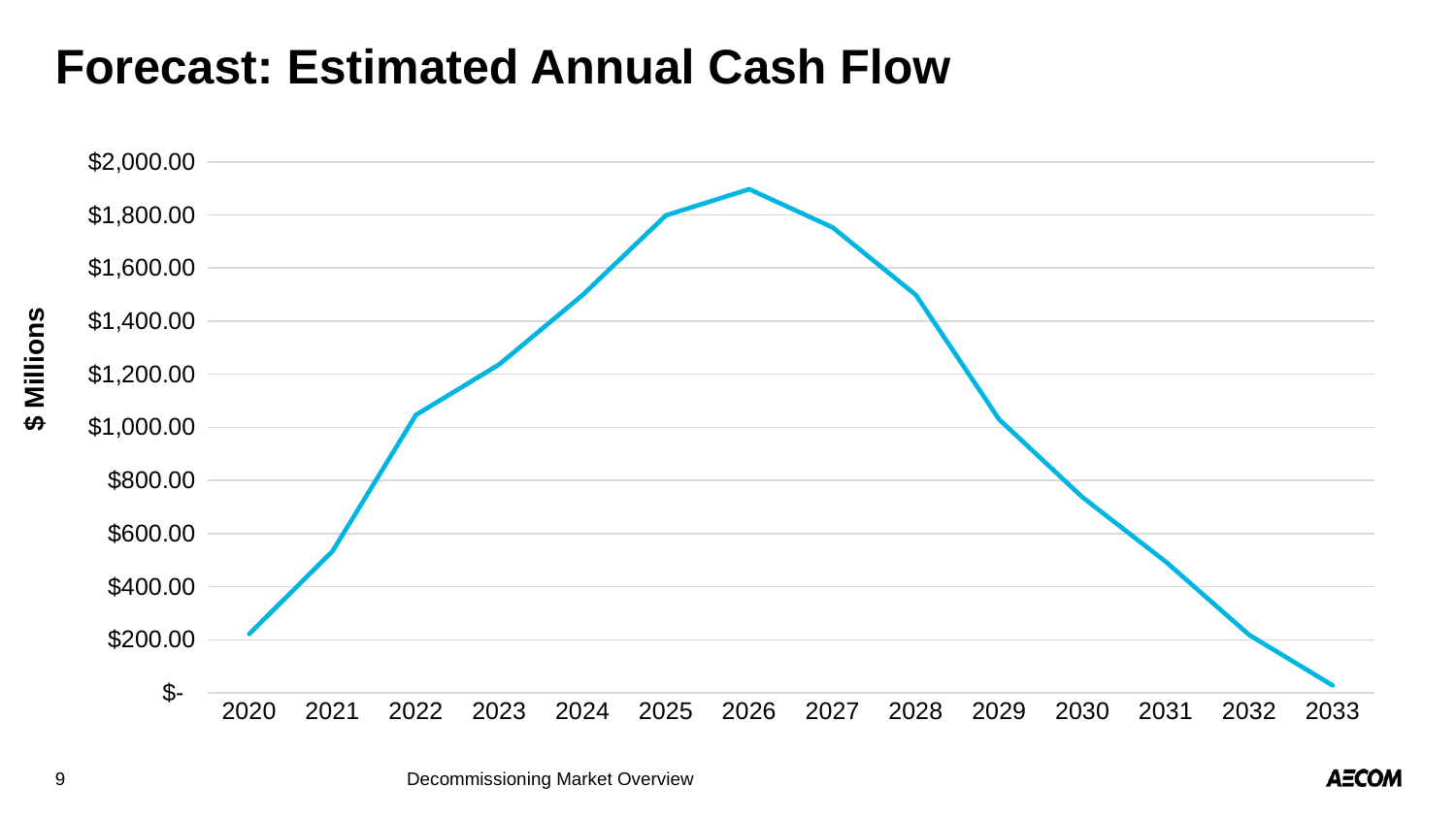
What kind of chart is shown on the slide? line chart Is the value for 2020 greater or less than $400.00? less How does the estimated annual cash flow change from 2026 to 2033? It falls Is the value for 2026 greater or less than $1,800.00? greater Which year has the highest estimated annual cash flow? 2026 Is the value for 2031 greater or less than $600.00? less What is the label on the vertical axis of the chart? $ Millions Which year has the lowest estimated annual cash flow? 2033 How many years are plotted on the x axis? 14 Which year has the larger estimated cash flow, 2025 or 2030? 2025